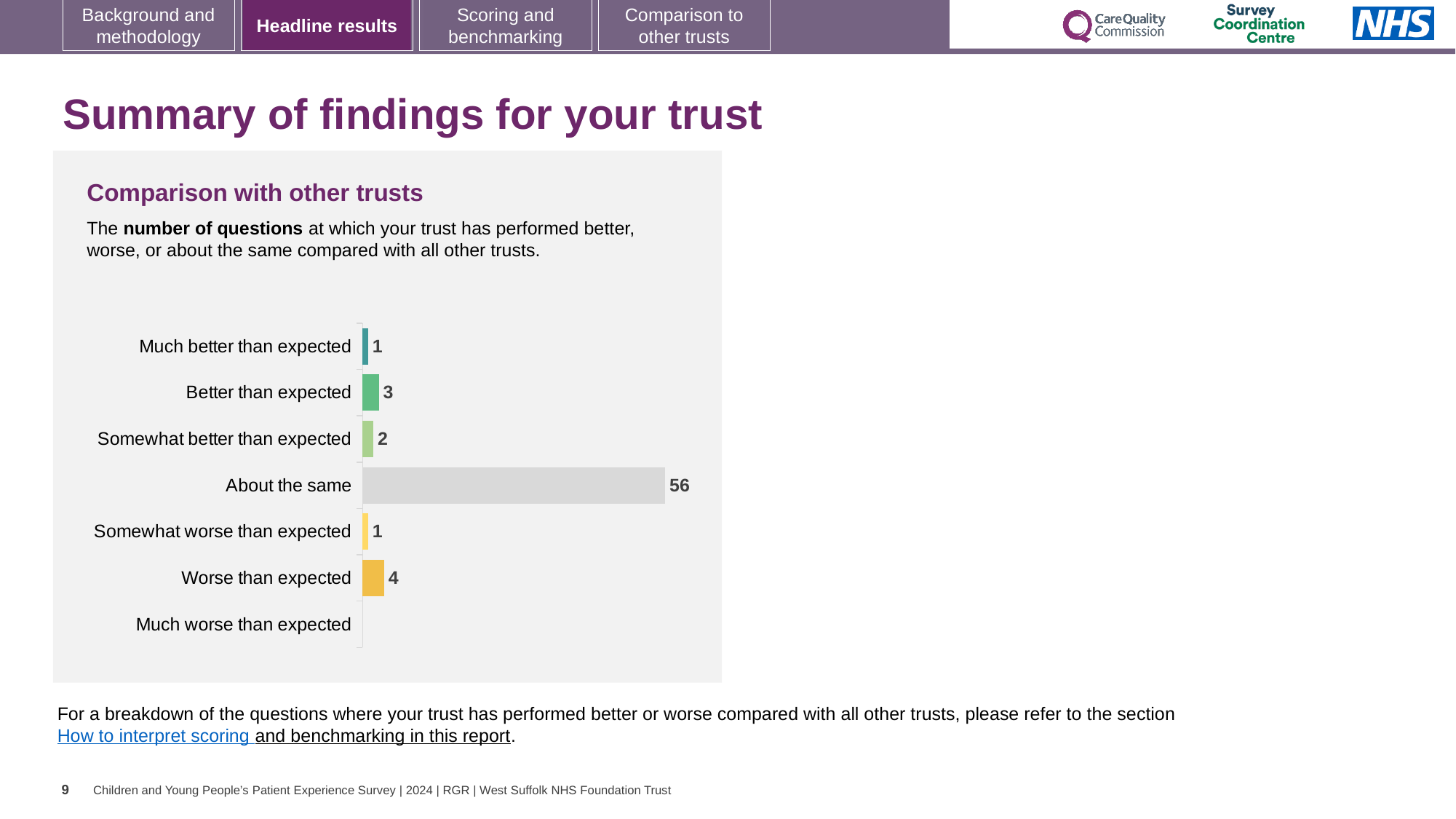
What is the value for 'Worse than expected'? 4 How many categories are listed on the chart? 7 What type of chart is shown on the slide? bar chart What is the total of 'Much better than expected', 'Better than expected' and 'Somewhat better than expected'? 6 What is the difference between 'About the same' and 'Worse than expected'? 52 Which is larger, 'Worse than expected' or 'Better than expected'? Worse than expected What is the value for 'Better than expected'? 3 What is the title of the chart panel? Comparison with other trusts What is the value for 'Somewhat better than expected'? 2 What is the value for 'Much better than expected'? 1 How many questions were rated 'About the same'? 56 Which category has the highest value? About the same